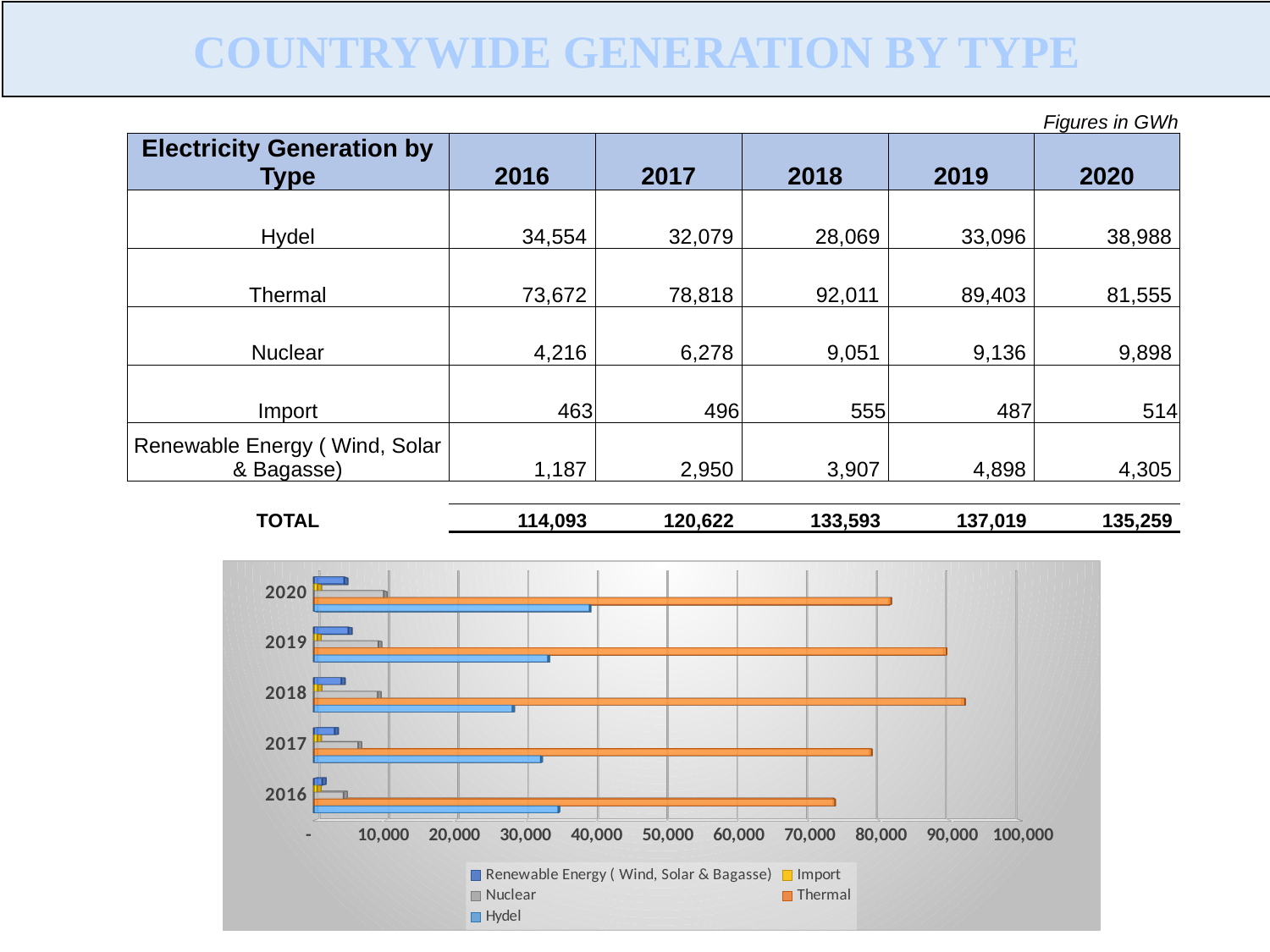
Is the Thermal bar for 2016 greater or less than 80,000? less Is the Hydel bar for 2018 greater or less than 30,000? less What kind of chart is shown on the slide? bar chart How many years are shown on the chart's vertical axis? 5 What colour represents Thermal in the chart's legend? orange According to the table on the slide, what is the Thermal generation value for 2018? 92,011 In which year is the Hydel bar the shortest? 2018 Using the values in the table, what is the difference between Hydel generation in 2020 and in 2016? 4,434 Which is larger, the Hydel bar for 2020 or the Hydel bar for 2019? 2020 Is the Thermal bar for 2019 greater or less than 80,000? greater In which year is the Thermal bar the longest? 2018 How many series does the chart's legend list? 5